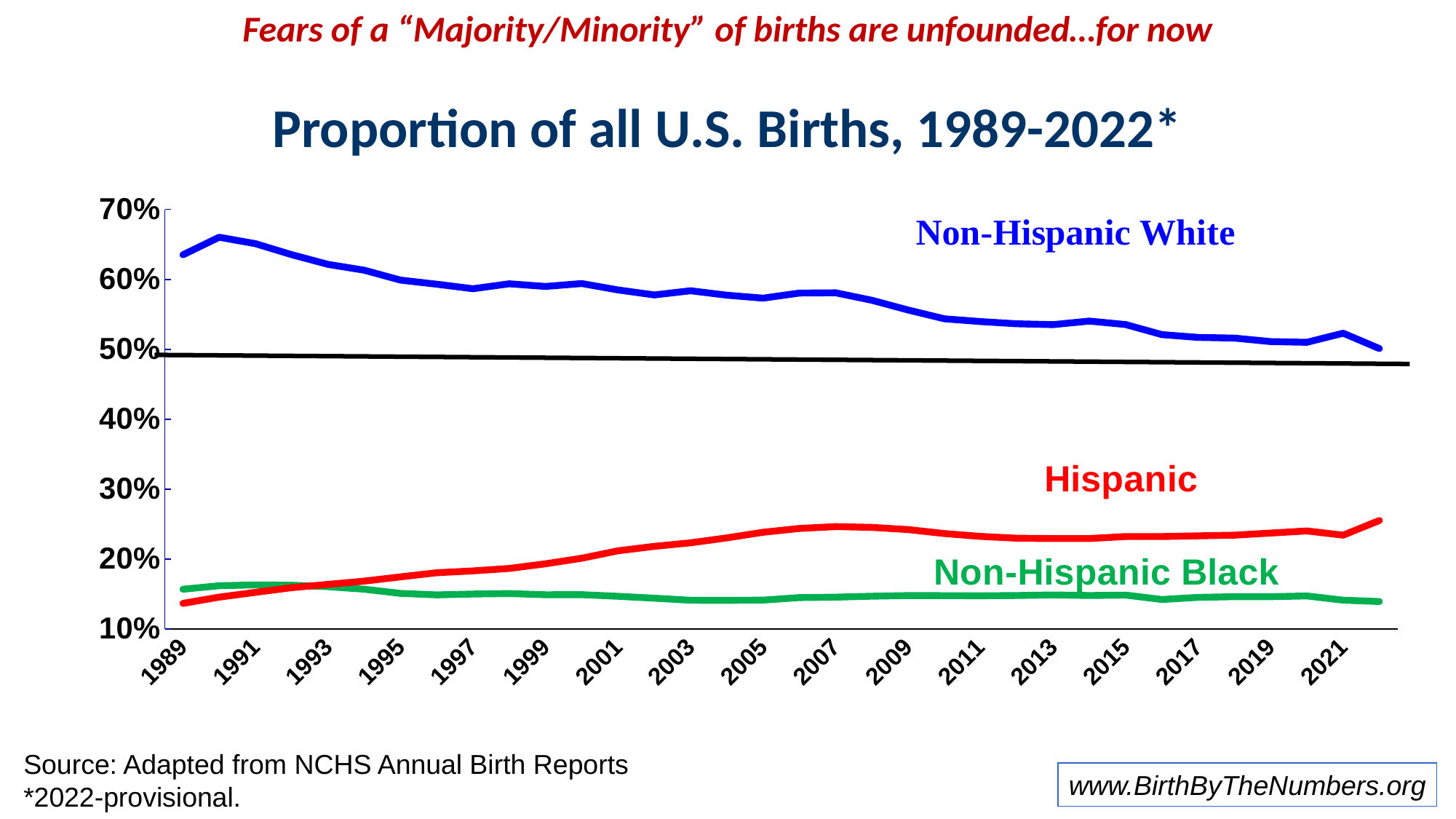
What colour is the Hispanic line? Red In 2021, which is larger: the Hispanic proportion or the Non-Hispanic Black proportion? Hispanic Is the Non-Hispanic White value for 2015 greater or less than 50%? greater What is the title of the chart? Proportion of all U.S. Births, 1989-2022* Does the Hispanic proportion rise or fall from 1989 to 2022? Rise Which series has the lowest proportion of births in 2021? Non-Hispanic Black What kind of chart is shown on the slide? Line chart Is the Hispanic value for 2007 greater or less than 20%? greater Is the Non-Hispanic White value for 1989 greater or less than 60%? greater Does the Non-Hispanic White proportion rise or fall from 1989 to 2022? Fall Which series has the highest proportion of births across the whole period? Non-Hispanic White How many labelled data series are plotted on the chart? 3